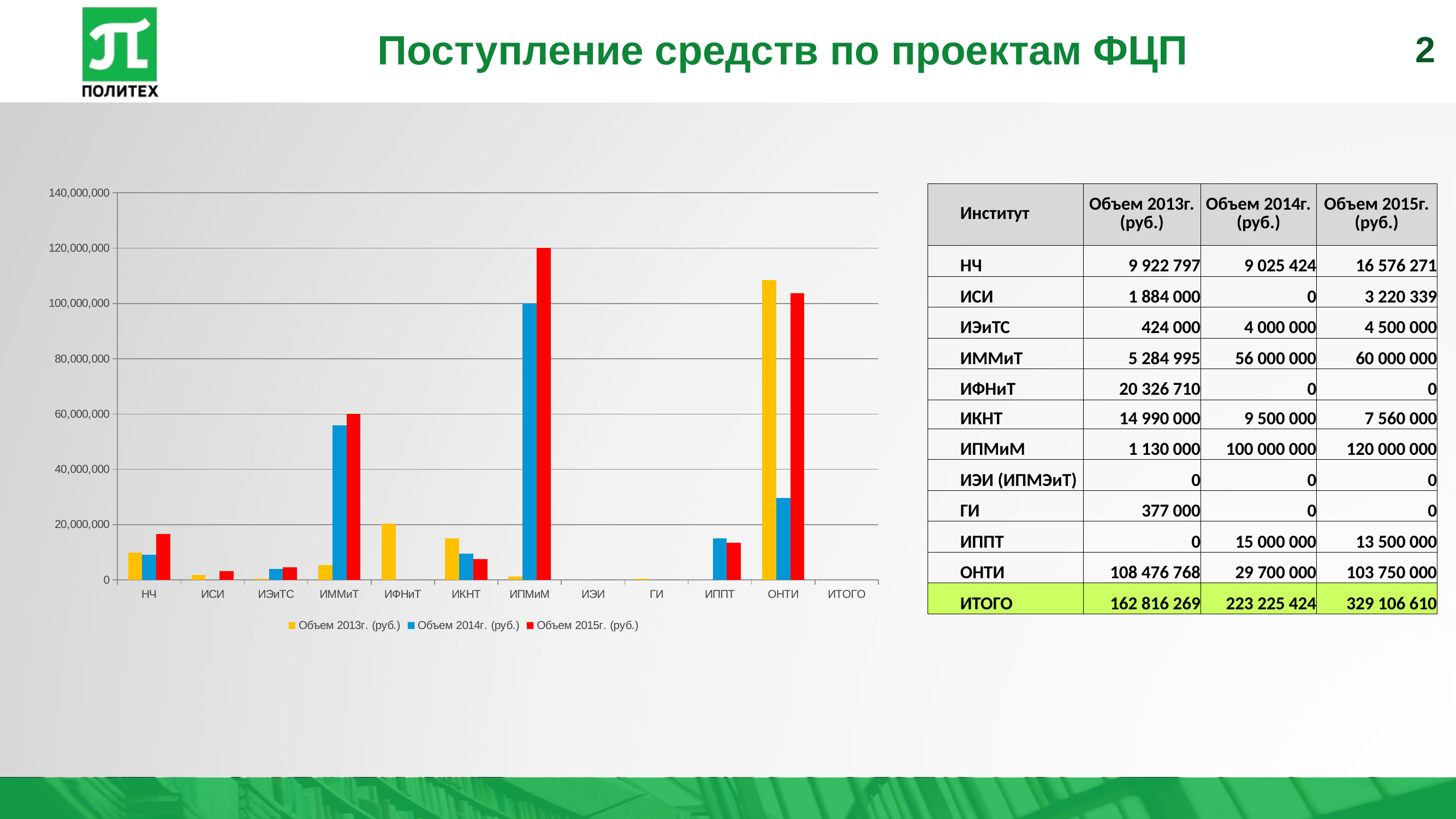
Is the value for ИПМиМ in the Объем 2014г. (руб.) series greater or less than 80,000,000? greater What is the value for ОНТИ in the Объем 2015г. (руб.) series? 103 750 000 How many series does the chart legend list? 3 Which colour represents the Объем 2014г. (руб.) series in the chart? blue Which is larger for ИКНТ: the Объем 2013г. (руб.) value or the Объем 2015г. (руб.) value? Объем 2013г. (руб.) How many categories are shown on the x axis of the chart? 12 What is the value for ИФНиТ in the Объем 2013г. (руб.) series? 20 326 710 What is the difference between the Объем 2015г. (руб.) and Объем 2014г. (руб.) values for ИПМиМ? 20 000 000 What kind of chart is shown on the slide? bar chart Which institute has the highest value for Объем 2015г. (руб.)? ИПМиМ What is the value for ИММиТ in the Объем 2014г. (руб.) series? 56 000 000 Which institute has the highest value for Объем 2013г. (руб.)? ОНТИ